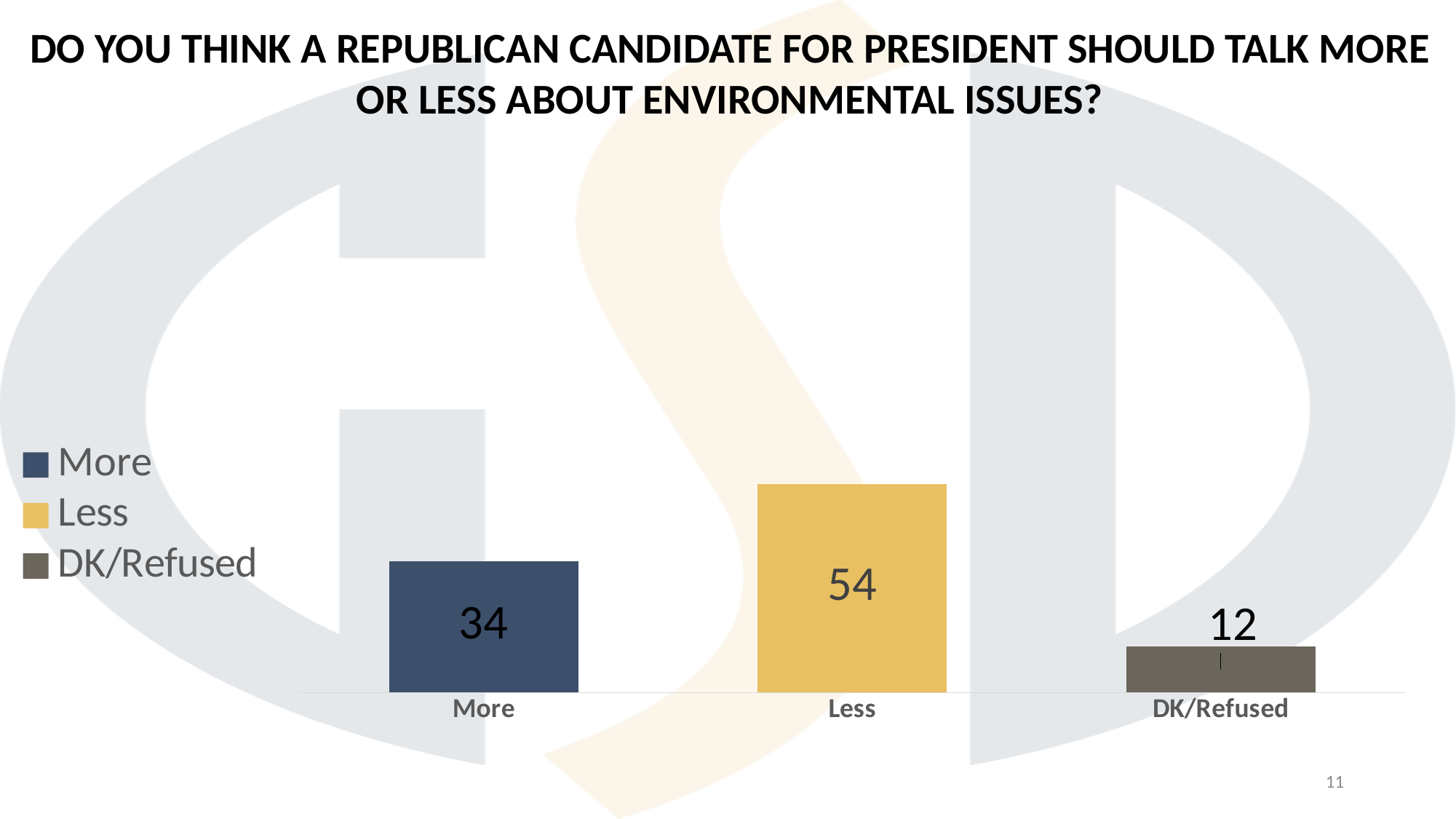
Which category has the lowest value? DK/Refused Which is larger, the value for More or the value for Less? Less How many entries does the legend list? 3 What is the value for More? 34 Which category has the highest value? Less What is the value for DK/Refused? 12 What is the value for Less? 54 What kind of chart is shown on the slide? Bar chart What is the difference between the values for Less and More? 20 How many categories are shown in the chart? 3 What colour is the bar for Less? Yellow What is the difference between the values for More and DK/Refused? 22